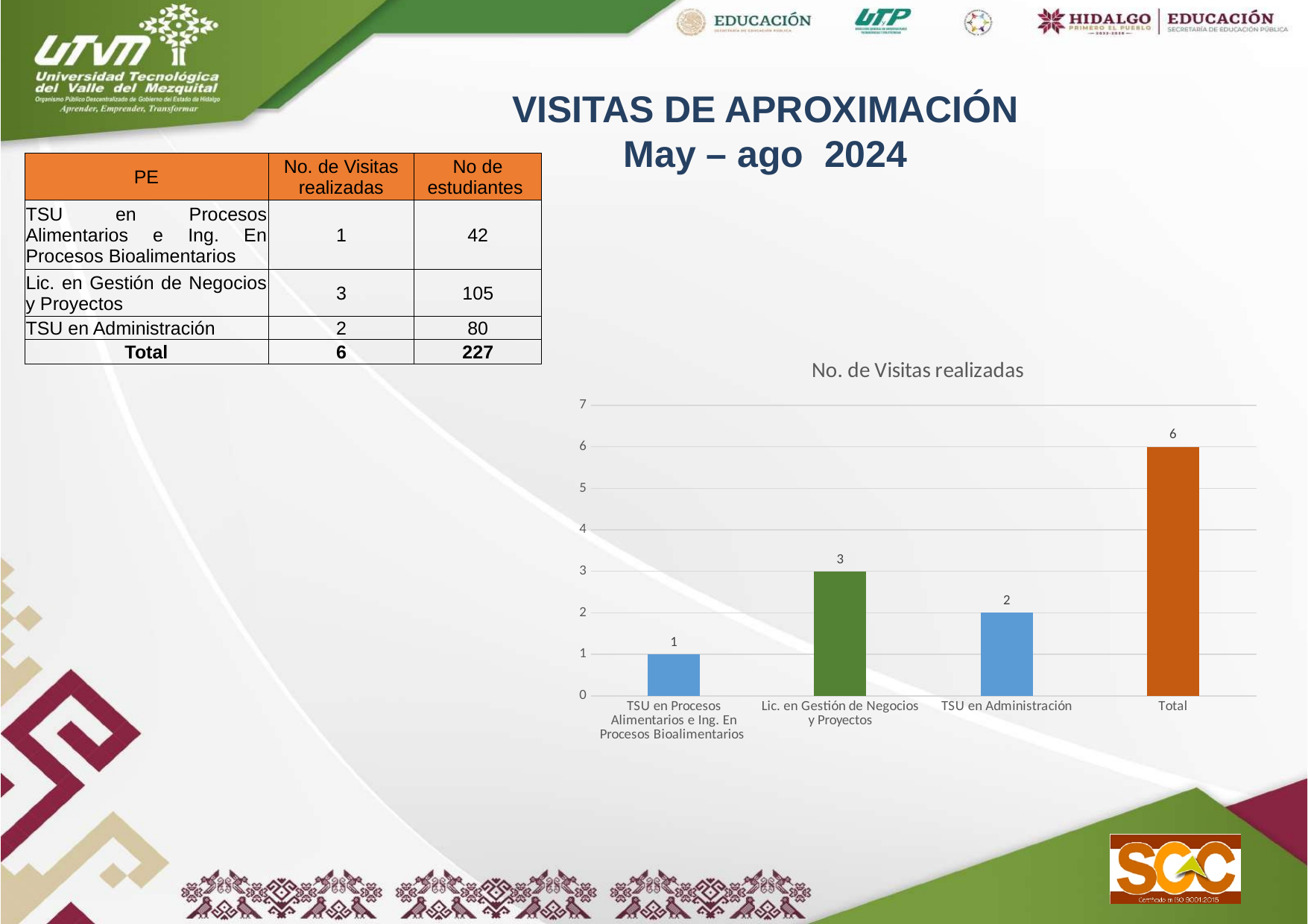
How many bars does the chart have? 4 What is the value for TSU en Administración? 2 What is the title of the chart? No. de Visitas realizadas What type of chart is shown on the slide? bar chart What is the value for TSU en Procesos Alimentarios e Ing. En Procesos Bioalimentarios? 1 Which is larger, the value for TSU en Administración or the value for TSU en Procesos Alimentarios e Ing. En Procesos Bioalimentarios? TSU en Administración Which category has the lowest number of visits? TSU en Procesos Alimentarios e Ing. En Procesos Bioalimentarios What is the value of the Total bar? 6 What is the difference between the values for Lic. en Gestión de Negocios y Proyectos and TSU en Administración? 1 Excluding the Total bar, which category has the highest number of visits? Lic. en Gestión de Negocios y Proyectos What is the value for Lic. en Gestión de Negocios y Proyectos? 3 What is the highest value shown on the vertical axis? 7